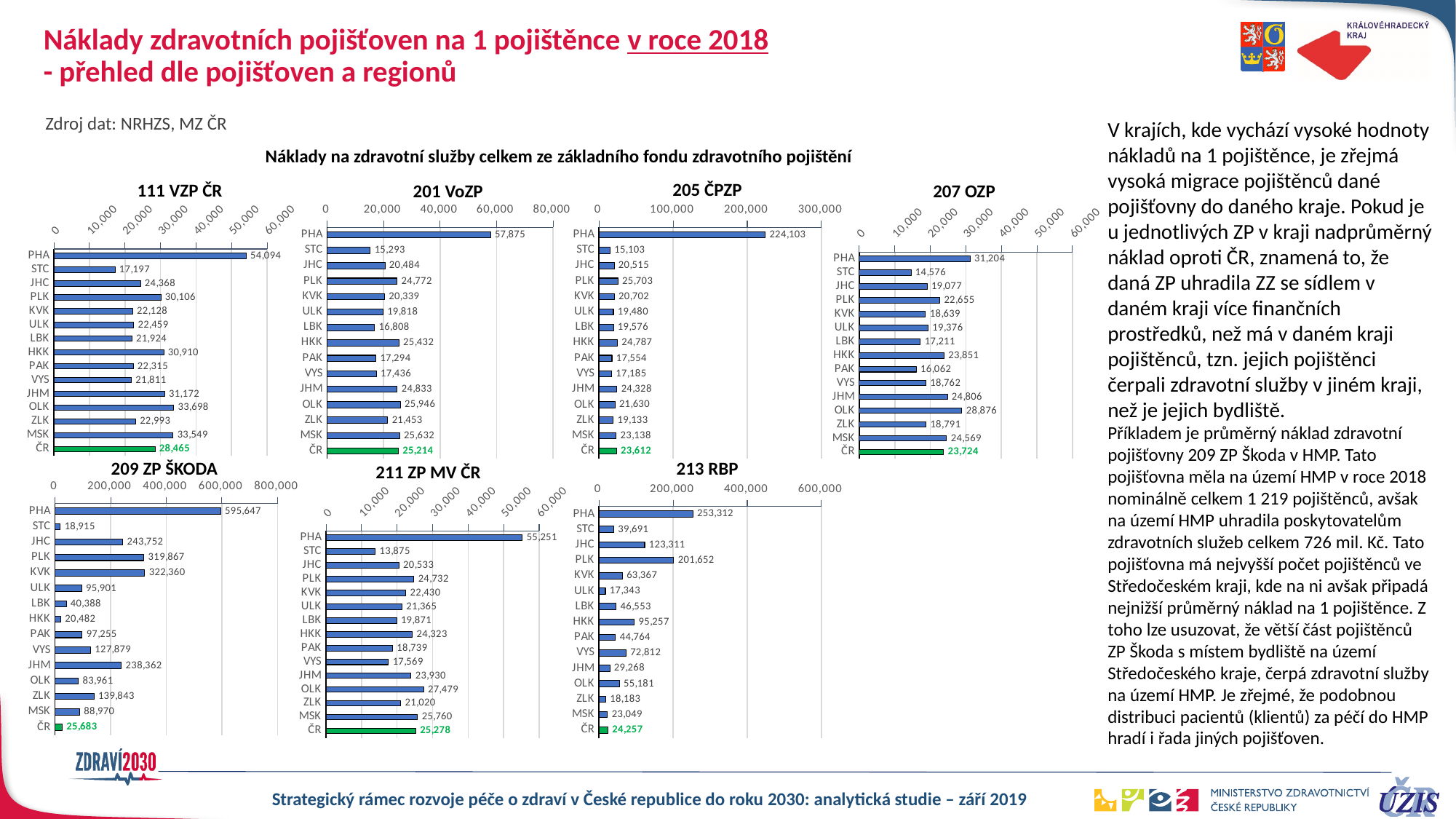
In the chart titled 207 OZP, which region has the lowest value? STC In the chart titled 205 ČPZP, which region has the highest value? PHA What kind of chart is the chart titled 213 RBP? bar chart In the chart titled 209 ZP ŠKODA, what is the difference between the values for PHA and STC? 576,732 In the chart titled 111 VZP ČR, what is the value for HKK? 30,910 In the chart titled 209 ZP ŠKODA, which is larger, the value for KVK or the value for PLK? KVK In the chart titled 213 RBP, which is larger, the value for JHC or the value for PLK? PLK In the chart titled 207 OZP, what is the value for PAK? 16,062 How many categories are shown in the chart titled 111 VZP ČR? 15 In the chart titled 201 VoZP, what is the value for ČR? 25,214 How many bar charts are shown on the slide? 7 In the chart titled 211 ZP MV ČR, is the value for PHA greater or less than 50,000? greater